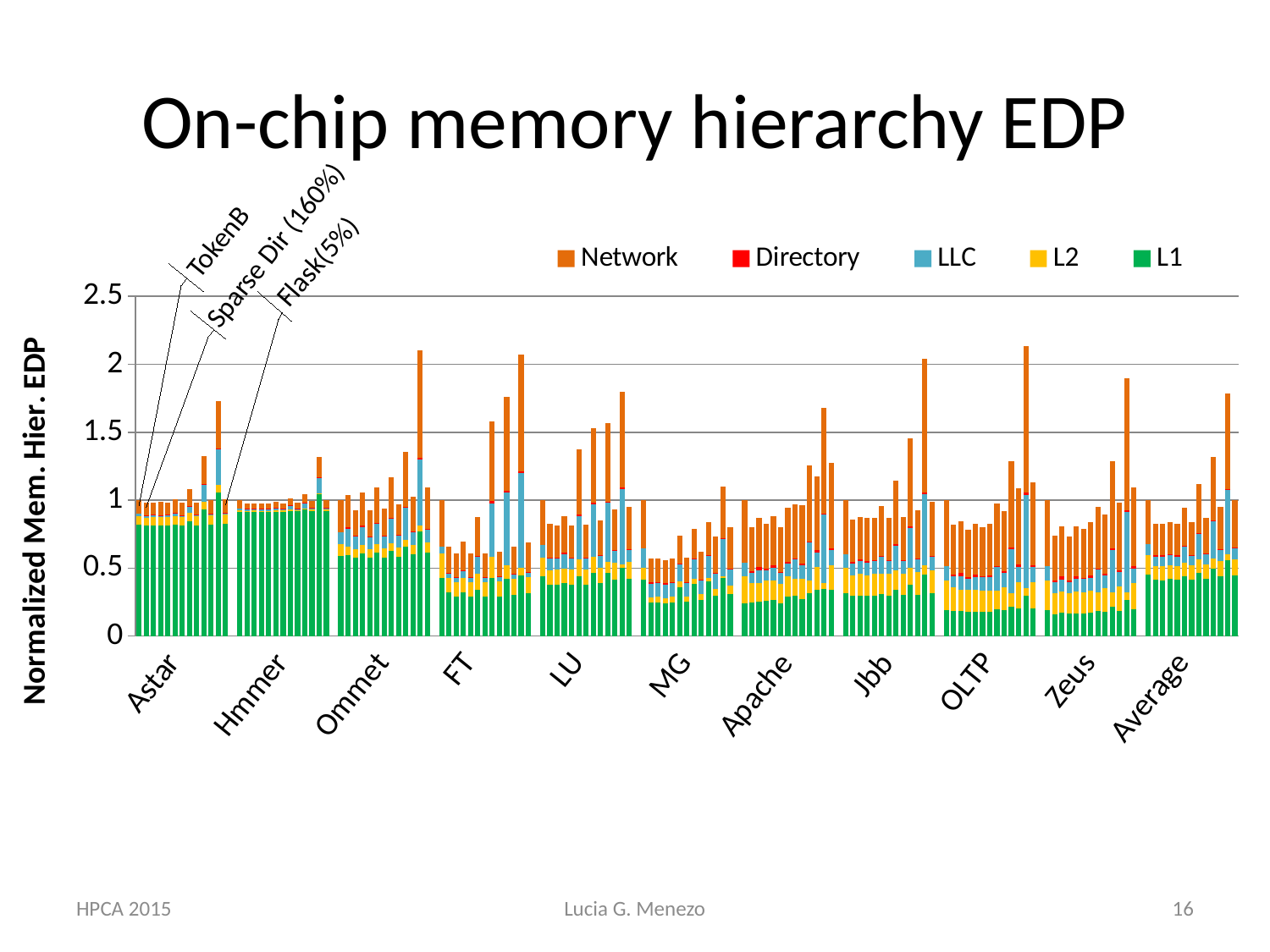
How many benchmark groups are labelled along the x axis? 11 What is the title of the chart? On-chip memory hierarchy EDP What kind of chart is shown on the slide? stacked bar chart What is the label of the y axis? Normalized Mem. Hier. EDP Is the tallest bar in the OLTP group greater or less than 2? greater Is the tallest bar in the Hmmer group greater or less than 1.5? less Is the tallest bar in the MG group greater or less than 1.5? less Which group has the taller tallest bar, OLTP or MG? OLTP How many series does the legend list? 5 Which group has the taller tallest bar, Hmmer or Astar? Astar What is the highest value shown on the y axis? 2.5